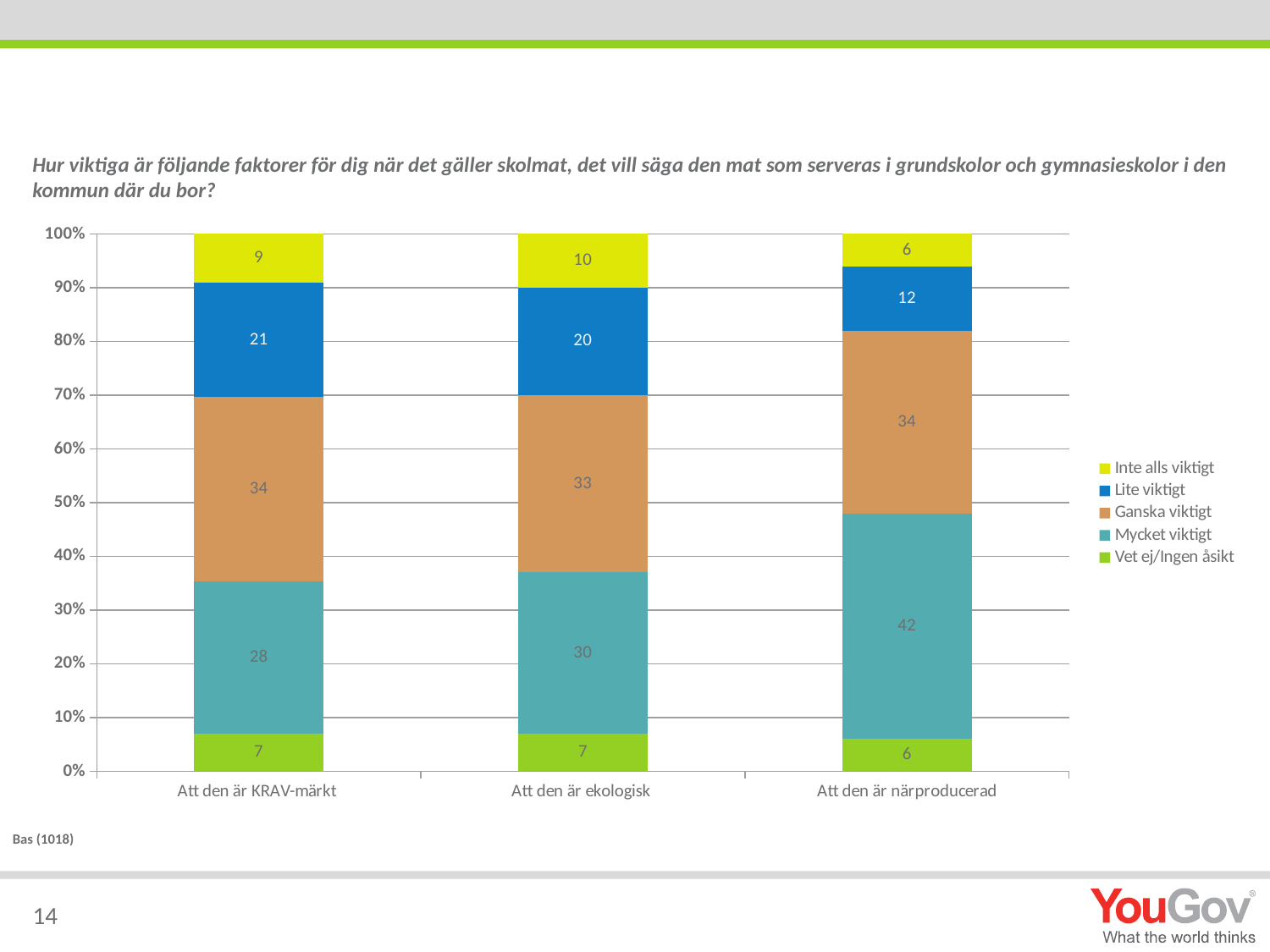
What is the value for "Vet ej/Ingen åsikt" for "Att den är närproducerad"? 6 What is the value for "Mycket viktigt" for "Att den är närproducerad"? 42 Which category has the lowest value for "Lite viktigt"? Att den är närproducerad What is the difference between the "Mycket viktigt" values for "Att den är närproducerad" and "Att den är KRAV-märkt"? 14 What is the value for "Lite viktigt" for "Att den är KRAV-märkt"? 21 Which legend entry is shown in dark blue? Lite viktigt Which category has the highest value for "Mycket viktigt"? Att den är närproducerad How many categories are shown on the x axis? 3 What is the value for "Inte alls viktigt" for "Att den är ekologisk"? 10 How many series does the legend list? 5 What kind of chart is shown on the slide? Stacked bar chart Which is larger: the "Ganska viktigt" value for "Att den är KRAV-märkt" or for "Att den är ekologisk"? Att den är KRAV-märkt